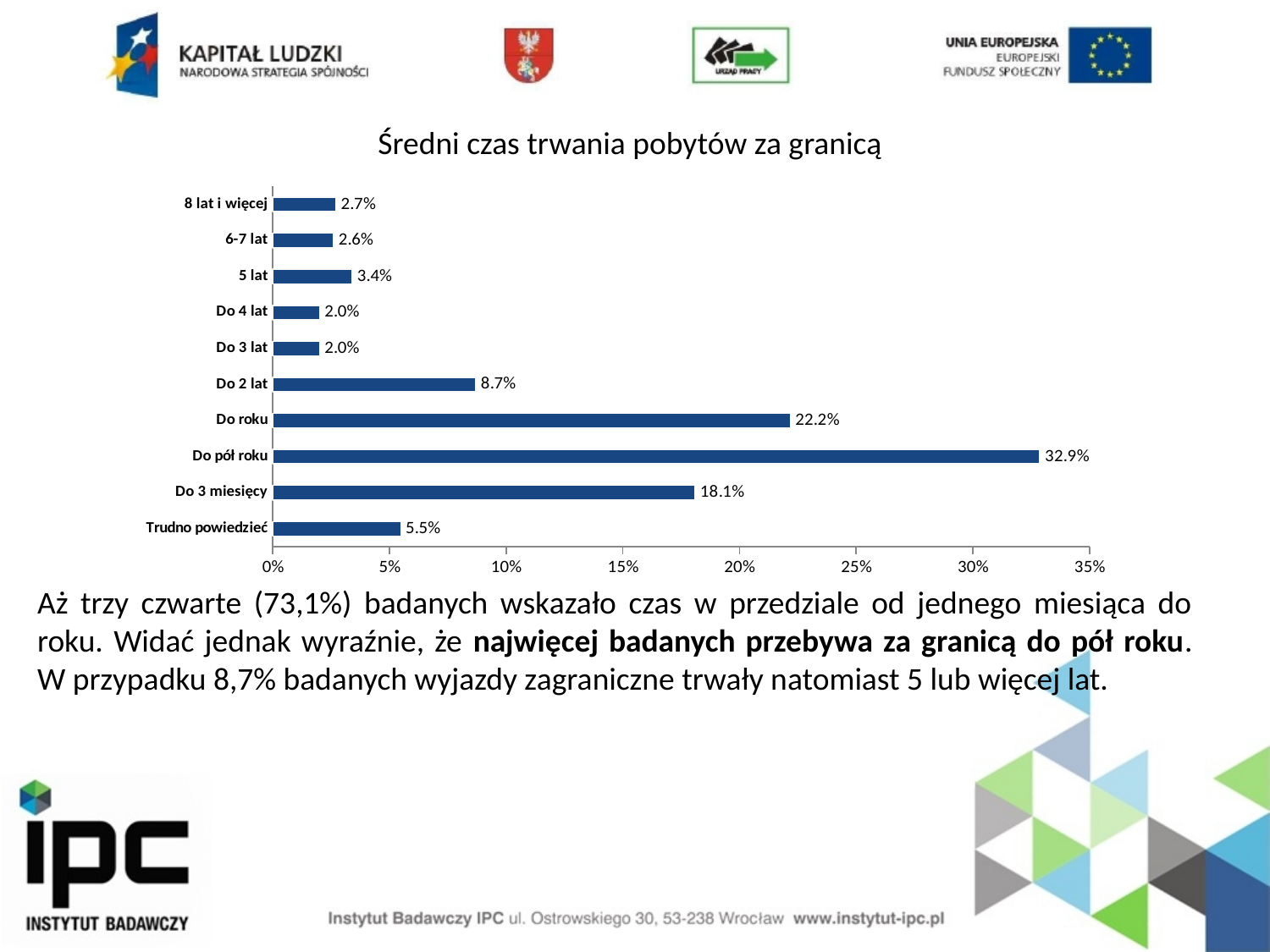
What is the value for "Do 3 miesięcy"? 18.1% What is the difference between the values for "Do pół roku" and "Do roku"? 10.7% What is the value for "8 lat i więcej"? 2.7% Which category has the highest value? Do pół roku What is the title of the chart? Średni czas trwania pobytów za granicą How many categories are shown on the chart? 10 What kind of chart is shown on the slide? bar chart Is the value for "Do roku" greater or less than 20%? greater What is the value for "Do pół roku"? 32.9% Which is larger, the value for "Do 2 lat" or the value for "5 lat"? Do 2 lat What is the difference between the values for "5 lat" and "6-7 lat"? 0.8% What is the value for "Trudno powiedzieć"? 5.5%